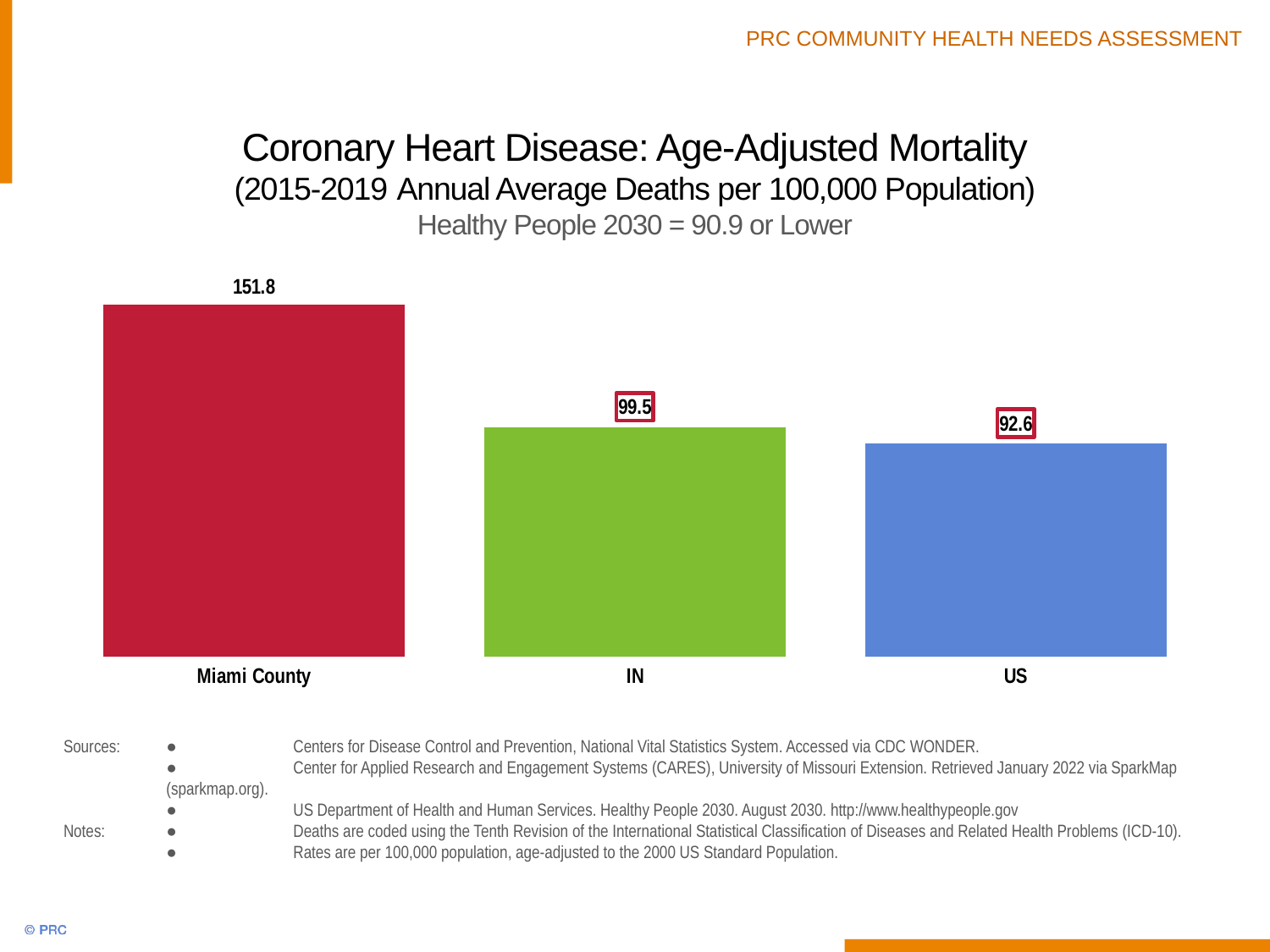
What kind of chart is shown on the slide? Bar chart Which category has the lowest coronary heart disease mortality rate? US What is the difference between the Miami County rate and the US rate? 59.2 What is the difference between the Miami County rate and the IN rate? 52.3 Which is larger, the rate for Miami County or the rate for IN? Miami County Which category has the highest coronary heart disease mortality rate? Miami County What is the difference between the IN rate and the US rate? 6.9 What is the Healthy People 2030 target stated in the chart subtitle? 90.9 or Lower What is the coronary heart disease age-adjusted mortality rate for IN? 99.5 How many categories are shown in the chart? 3 What is the coronary heart disease age-adjusted mortality rate for Miami County? 151.8 What is the coronary heart disease age-adjusted mortality rate for the US? 92.6